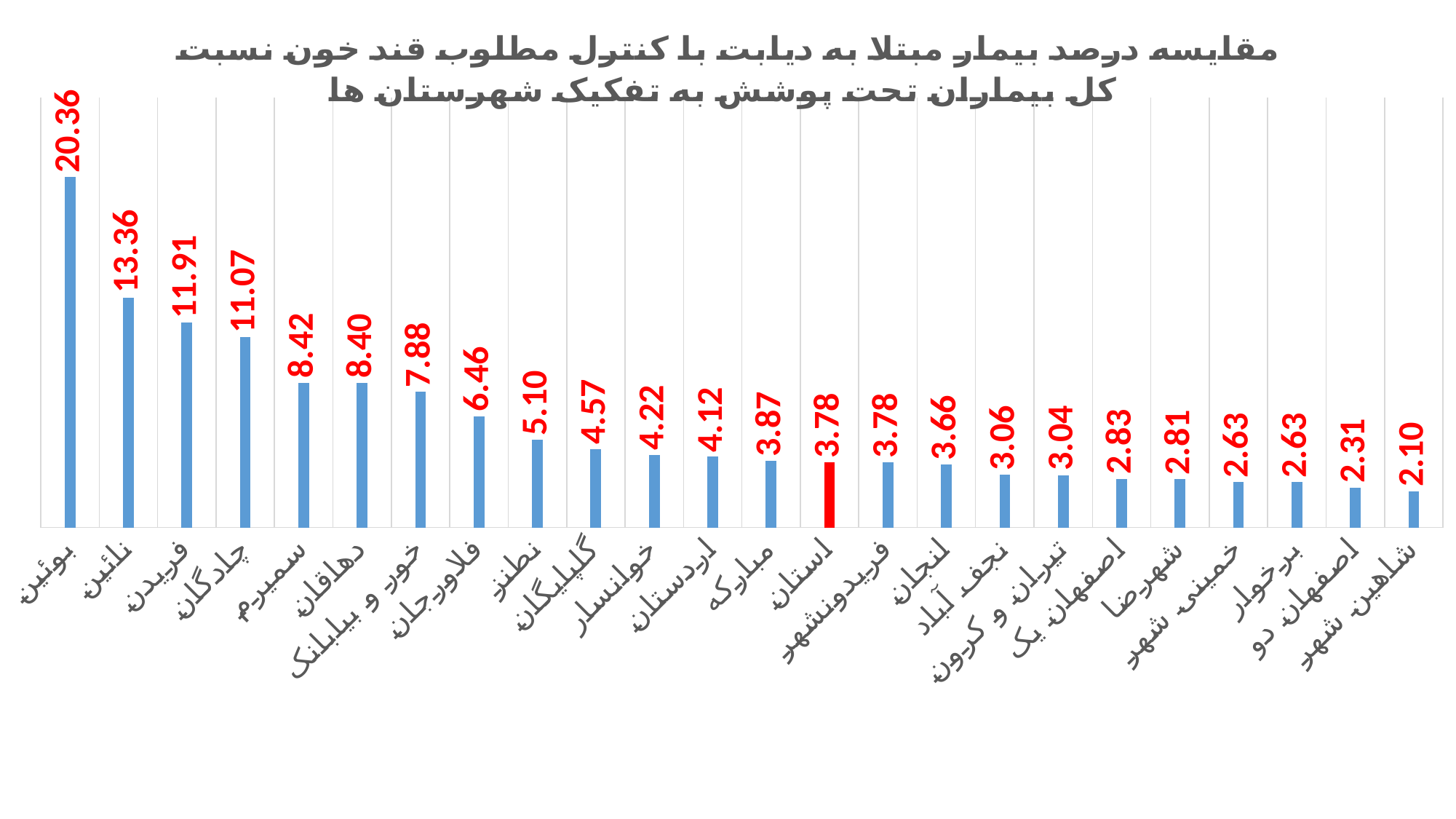
Which is larger, the value for سمیرم or the value for نطنز? سمیرم What type of chart is shown on the slide? bar chart Which category has the lowest value? شاهین شهر What is the value for فلاورجان? 6.46 What is the value for بوئین? 20.36 Do the values rise or fall from left to right along the x axis? fall What is the difference between the values for لنجان and نجف آباد? 0.60 What is the difference between the values for بوئین and نائین? 7.00 Which bar is coloured red instead of blue? استان Which category has the highest value? بوئین How many bars are plotted in the chart? 24 What is the value for استان? 3.78